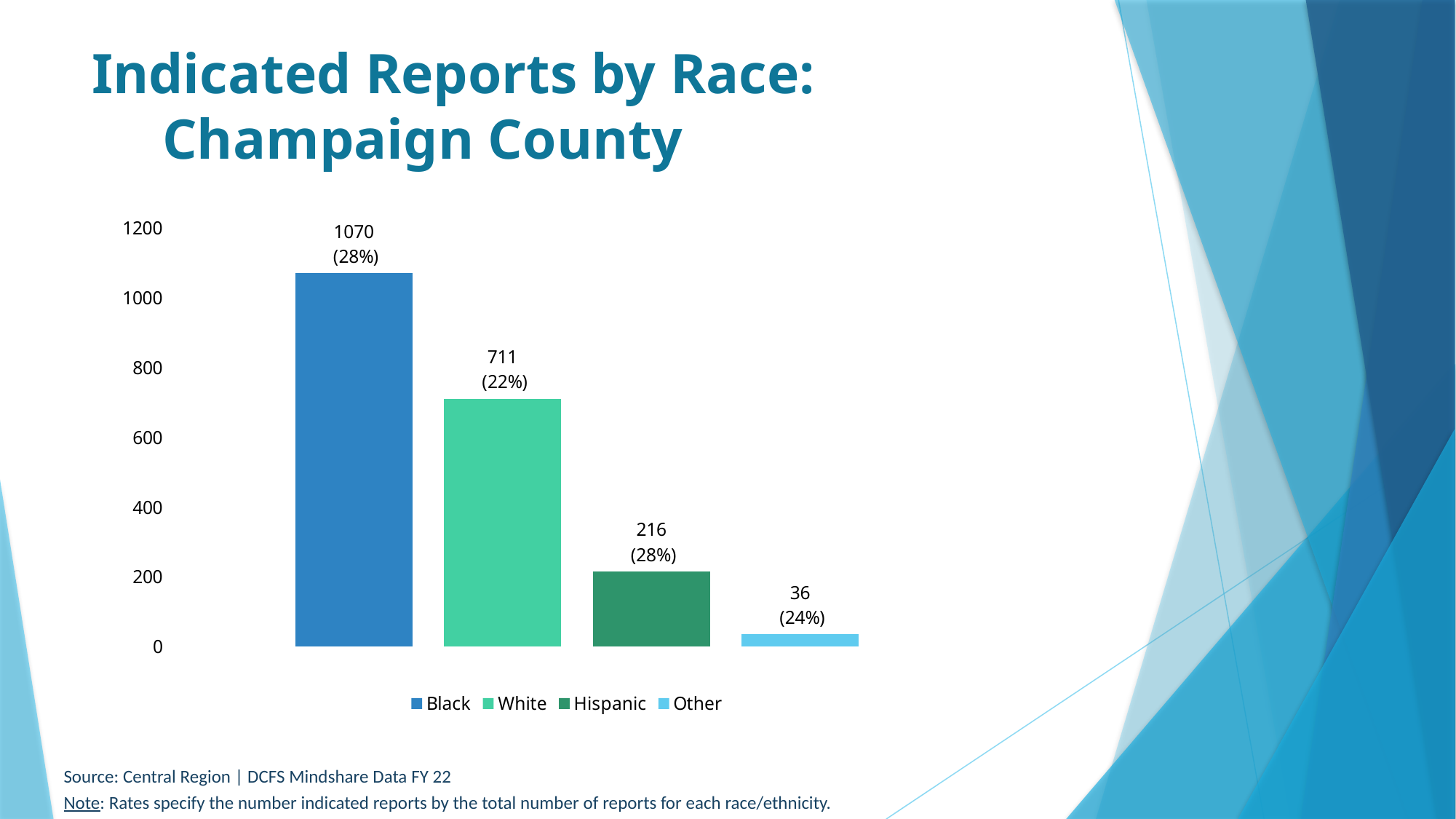
How many indicated reports are shown for Black? 1070 What is the difference between the number of indicated reports for Black and White? 359 Which category has the lowest number of indicated reports? Other What rate is shown in parentheses for Other? 24% Which has more indicated reports, Hispanic or Other? Hispanic How many indicated reports are shown for Hispanic? 216 What kind of chart is shown on the slide? bar chart Is the value for White greater or less than 800? less Which category has the highest number of indicated reports? Black How many indicated reports are shown for White? 711 How many categories are shown in the chart? 4 What is the title of the slide? Indicated Reports by Race: Champaign County